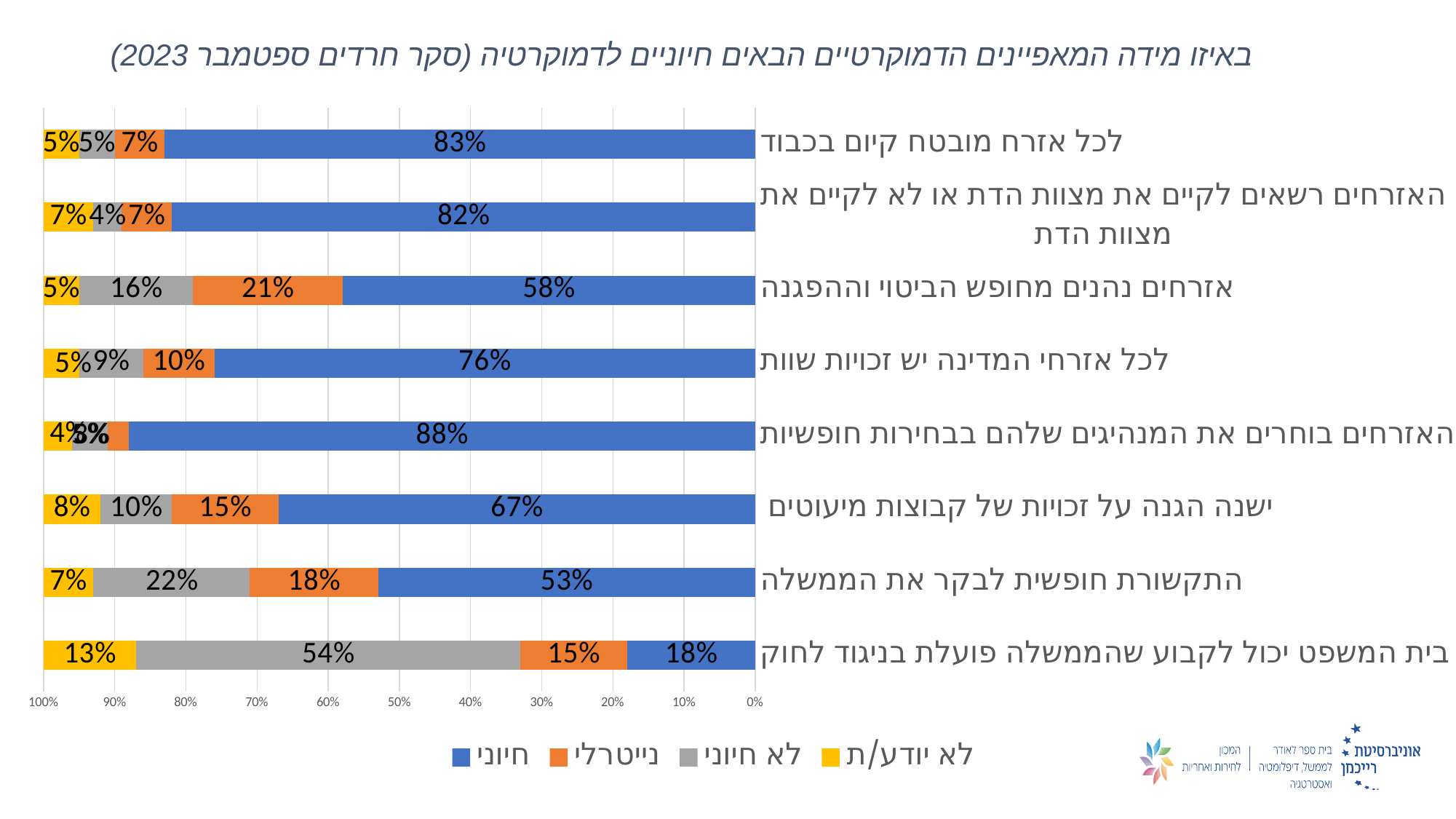
Which is larger: the לא חיוני value for 'התקשורת חופשית לבקר את הממשלה' or for 'אזרחים נהנים מחופש הביטוי וההפגנה'? התקשורת חופשית לבקר את הממשלה What is the value of חיוני for 'לכל אזרח מובטח קיום בכבוד'? 83% What kind of chart is shown on the slide? Stacked bar chart What is the difference between the חיוני values for 'לכל אזרחי המדינה יש זכויות שוות' and 'התקשורת חופשית לבקר את הממשלה'? 23% How many series does the legend list? 4 Which colour represents the series נייטרלי in the chart? Orange What is the value of לא יודע/ת for 'ישנה הגנה על זכויות של קבוצות מיעוטים'? 8% How many categories (statements) are plotted in the chart? 8 What is the value of לא חיוני for 'בית המשפט יכול לקבוע שהממשלה פועלת בניגוד לחוק'? 54% Which category has the highest חיוני value? האזרחים בוחרים את המנהיגים שלהם בבחירות חופשיות What is the value of נייטרלי for 'אזרחים נהנים מחופש הביטוי וההפגנה'? 21% Which category has the lowest חיוני value? בית המשפט יכול לקבוע שהממשלה פועלת בניגוד לחוק